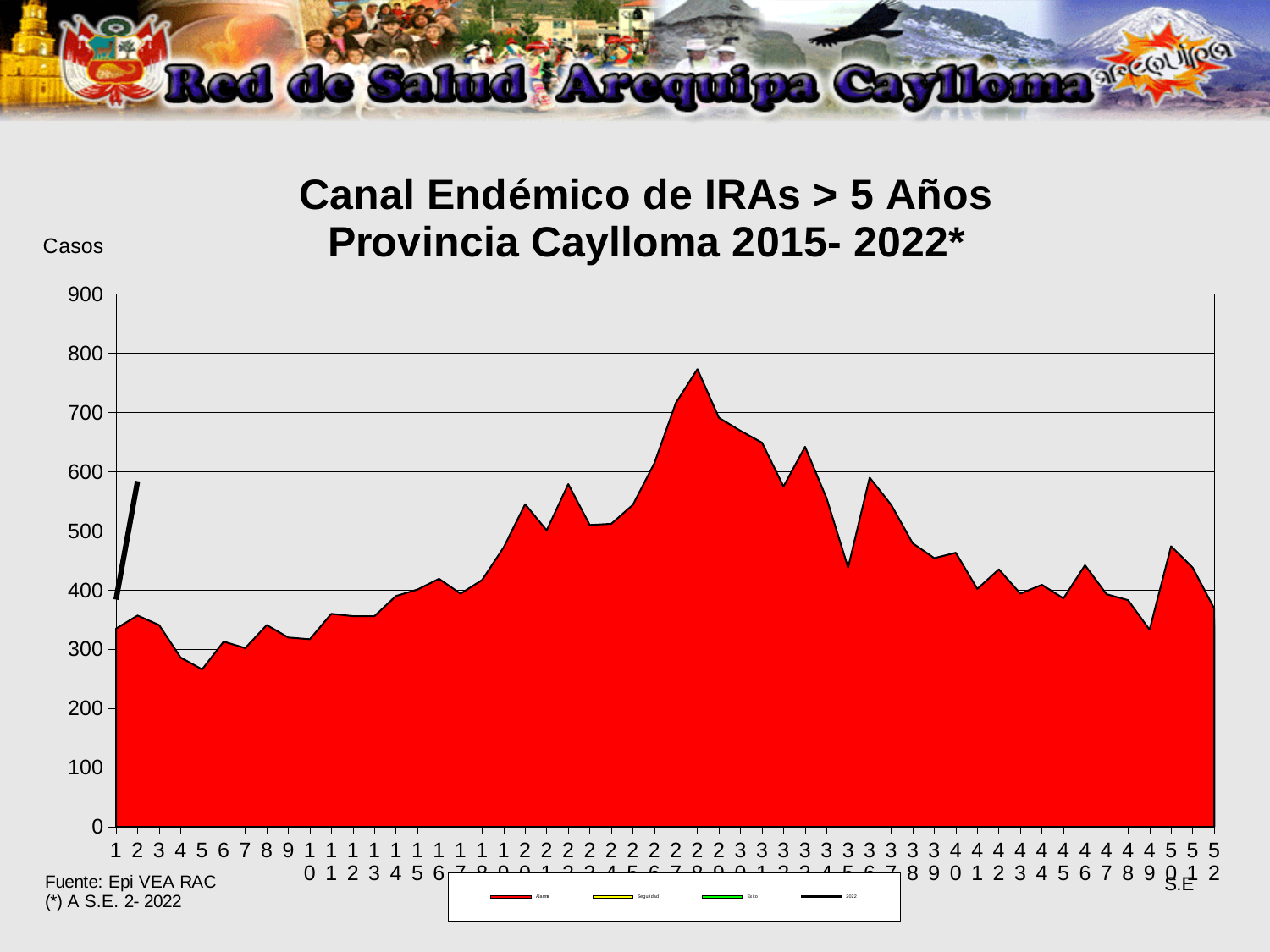
At which week does the red Alarma area reach its highest value? 28 Is the value of the red area at week 35 greater or less than 500? less Is the value of the red area at week 28 greater or less than 700? greater What kind of chart is shown on the slide? area chart How many epidemiological weeks (S.E.) are shown along the x axis? 52 How many series does the legend list? 4 Which is larger, the red area value at week 28 or at week 36? week 28 At which week does the red Alarma area reach its lowest value? 5 Do the values of the red area rise or fall from week 20 to week 28? rise What label is shown on the y axis of the chart? Casos Is the value of the red area at week 5 greater or less than 300? less